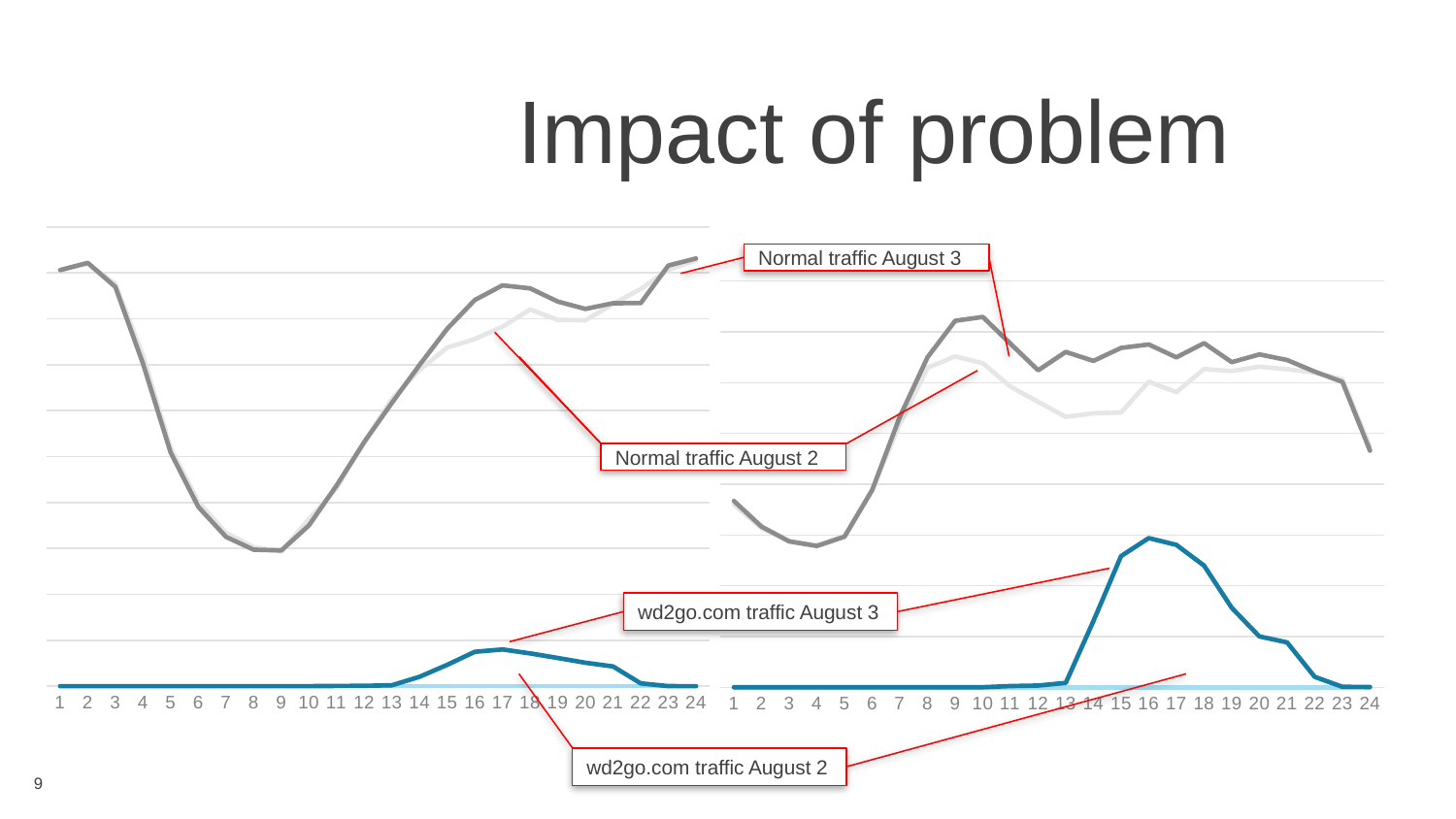
How many series are named by the callout labels on the slide? 4 In the right chart, does the normal traffic line rise or fall from point 4 to point 10? Rise In the right chart, at which x-axis point does the wd2go.com traffic August 3 line reach its highest value? 16 What is the title of the slide containing the charts? Impact of problem How many points are on the x axis of the right chart? 24 In the right chart, does the wd2go.com traffic August 3 line rise or fall from point 13 to point 16? Rise What kind of chart is shown on the left side of the slide? Line chart In the left chart, does the normal traffic line rise or fall from point 1 to point 8? Fall How many points are on the x axis of the left chart? 24 What kind of chart is shown on the right side of the slide? Line chart In the left chart, is the normal traffic value larger at point 2 or at point 8? Point 2 In the right chart, is the wd2go.com traffic August 3 value larger at point 16 or at point 1? Point 16